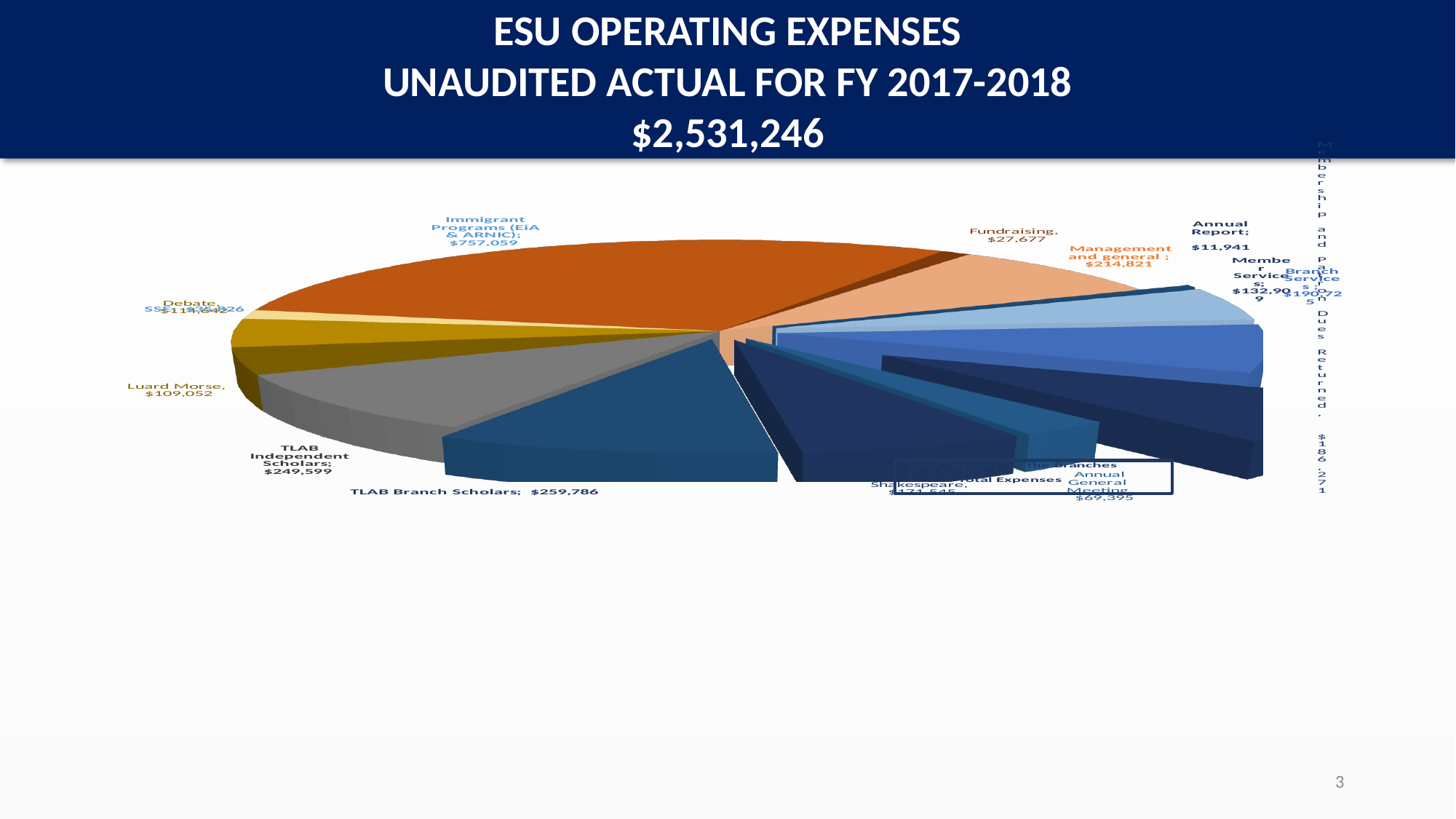
What is the difference between Immigrant Programs (EiA & ARNIC) and Management and general? $542,238 What is the value for TLAB Branch Scholars? $259,786 What is the value for Annual Report? $11,941 What total amount of operating expenses is stated in the slide title? $2,531,246 What is the value for TLAB Independent Scholars? $249,599 Which is larger, TLAB Branch Scholars or TLAB Independent Scholars? TLAB Branch Scholars Which category has the largest slice of the pie? Immigrant Programs (EiA & ARNIC) What is the value for Luard Morse? $109,052 What is the value for Fundraising? $27,677 What is the value for Management and general? $214,821 What is the value for Immigrant Programs (EiA & ARNIC)? $757,059 What kind of chart is shown on the slide? Pie chart